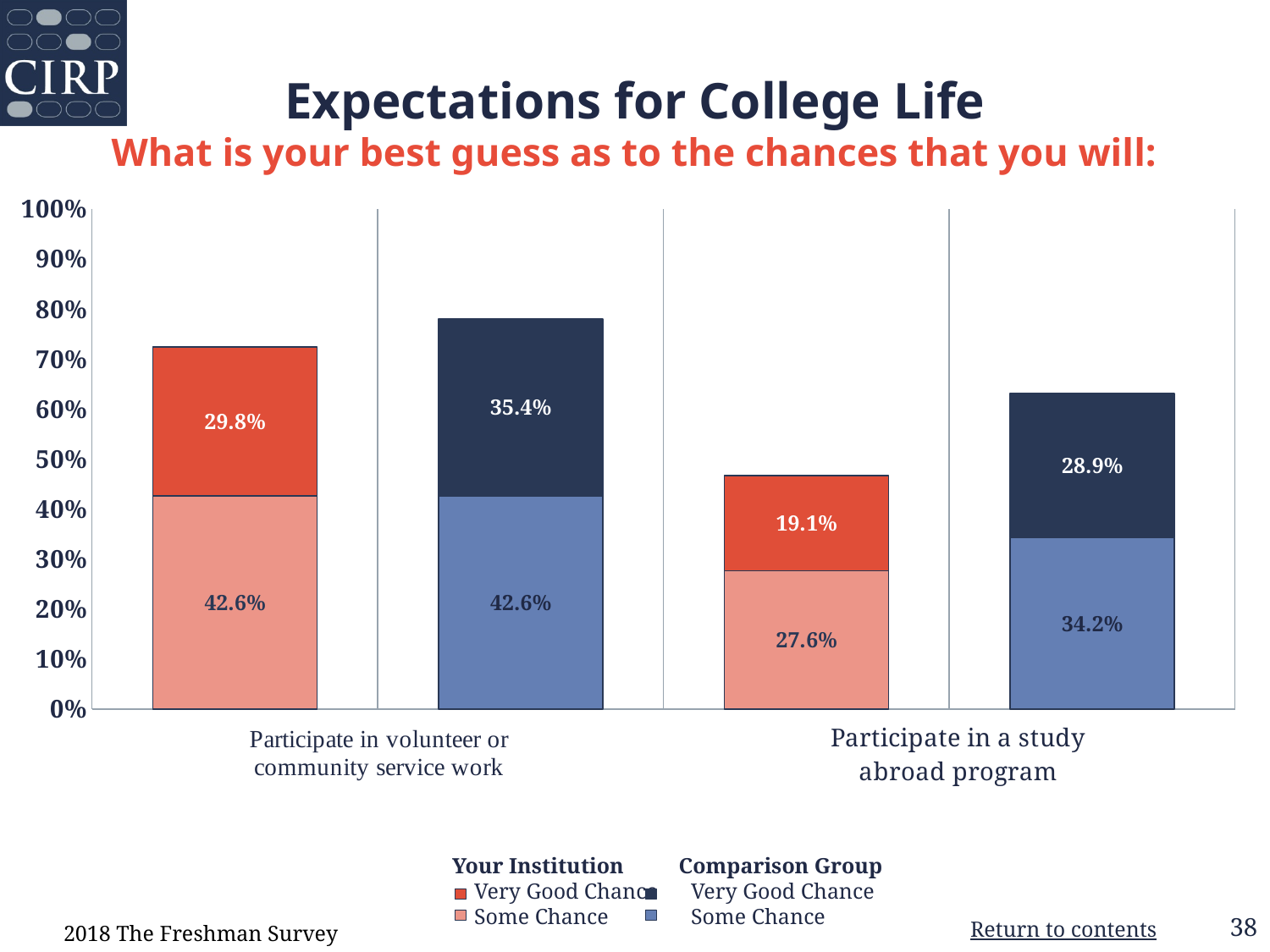
What is the difference between the Comparison Group and Your Institution 'Very Good Chance' values for 'Participate in volunteer or community service work'? 5.6% How many entries does the legend list? 4 What is the 'Some Chance' value for Your Institution for 'Participate in a study abroad program'? 27.6% Which stacked bar has the lowest total on the chart? Your Institution, Participate in a study abroad program What is the 'Very Good Chance' value for Your Institution for 'Participate in volunteer or community service work'? 29.8% What is the 'Very Good Chance' value for the Comparison Group for 'Participate in a study abroad program'? 28.9% What is the total of the stacked bar for Your Institution for 'Participate in volunteer or community service work'? 72.4% What is the 'Some Chance' value for the Comparison Group for 'Participate in a study abroad program'? 34.2% Which is larger for 'Participate in a study abroad program': the 'Some Chance' value for Your Institution or for the Comparison Group? Comparison Group Is the total of the Comparison Group bar for 'Participate in volunteer or community service work' greater or less than 70%? greater What is the total of the stacked bar for the Comparison Group for 'Participate in a study abroad program'? 63.1% What kind of chart is shown on the slide? Stacked bar chart